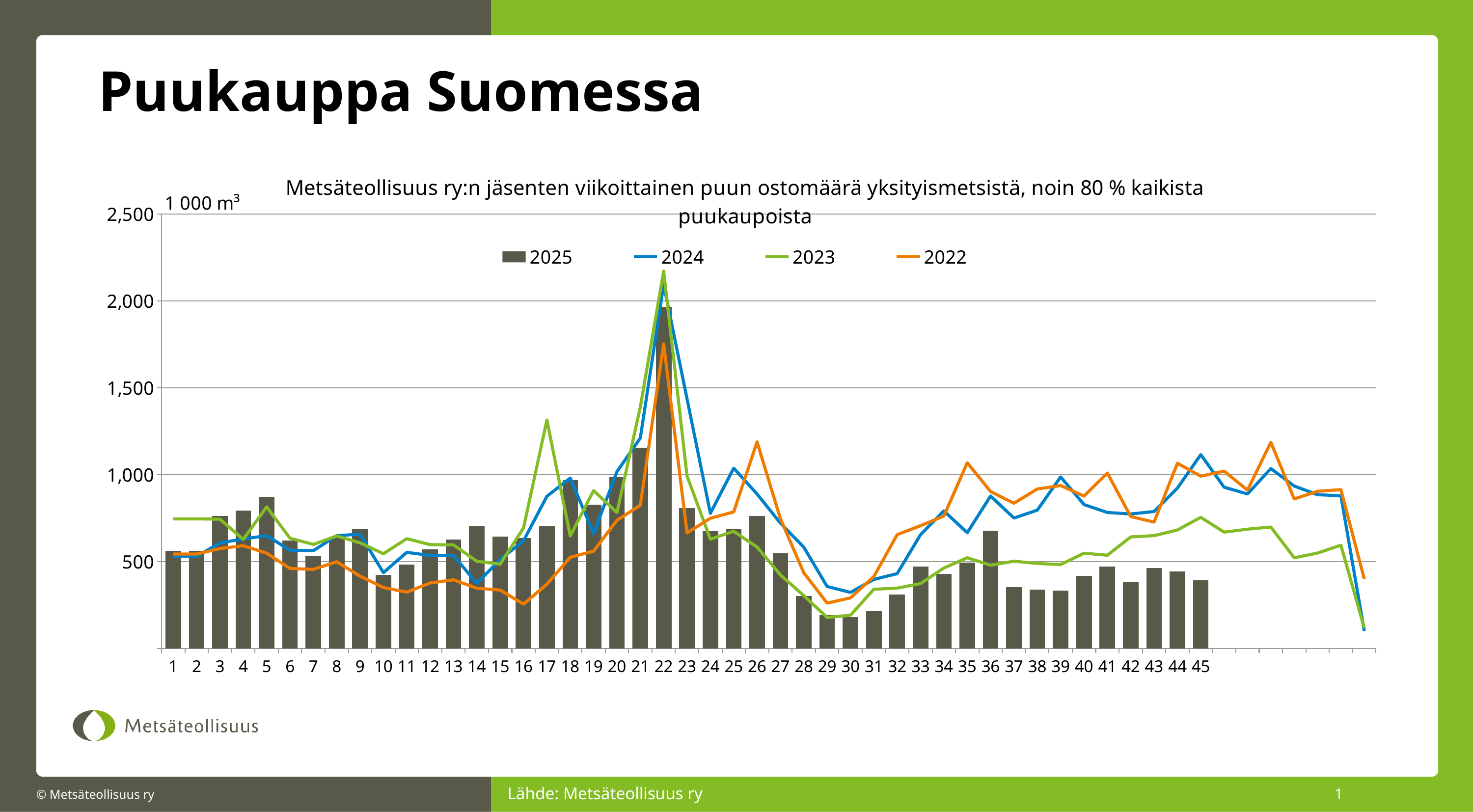
Is the 2025 value for week 22 greater or less than 1,500? greater How many weeks are labelled on the horizontal axis? 45 At week 22, which is higher, the 2023 line or the 2022 line? 2023 Is the 2022 value for week 26 greater or less than 1,000? greater Do the 2025 bars rise or fall from week 22 to week 30? fall In which week does the 2023 line reach its highest value? Week 22 What unit is shown at the top of the vertical axis? 1 000 m³ In which week is the 2025 bar highest? Week 22 Is the 2025 value for week 29 greater or less than 500? less How many series does the legend list? 4 What kind of chart is shown on the slide? A combined bar and line chart Which series is drawn as bars rather than a line? 2025